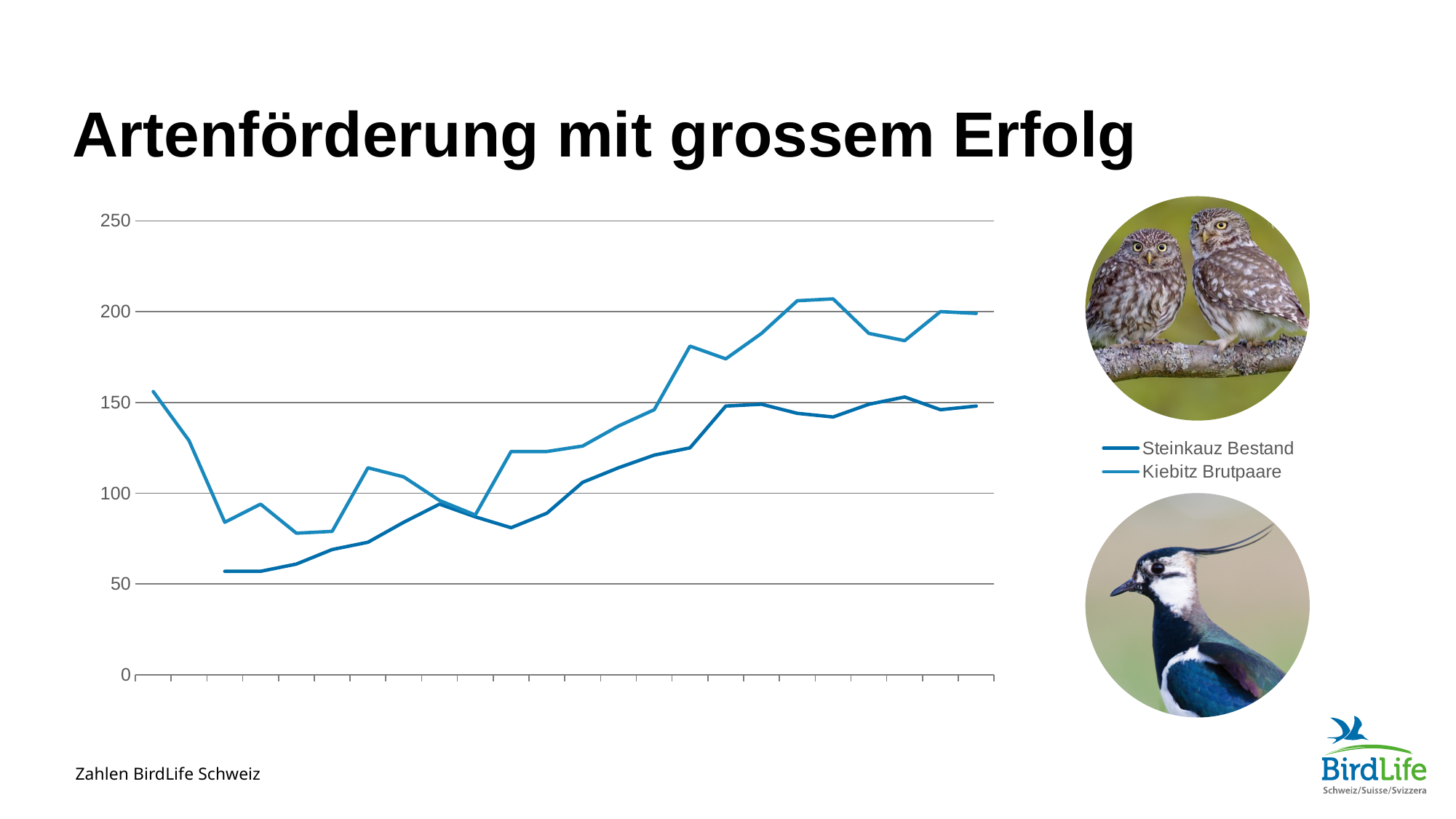
Is the first value of the Steinkauz Bestand series greater or less than 100? less Which series has the lowest point anywhere on the chart? Steinkauz Bestand Is the last value of the Kiebitz Brutpaare series greater or less than 150? greater Which series reaches the highest value anywhere on the chart? Kiebitz Brutpaare Does the Kiebitz Brutpaare series end higher or lower than it starts? higher What kind of chart is shown on the slide? line chart Is the last value of the Steinkauz Bestand series greater or less than 100? greater What are the two series named in the chart legend? Steinkauz Bestand and Kiebitz Brutpaare Does the Steinkauz Bestand series rise or fall overall from left to right? rise At the right end of the chart, which series has the higher value, Steinkauz Bestand or Kiebitz Brutpaare? Kiebitz Brutpaare How many series does the chart legend list? 2